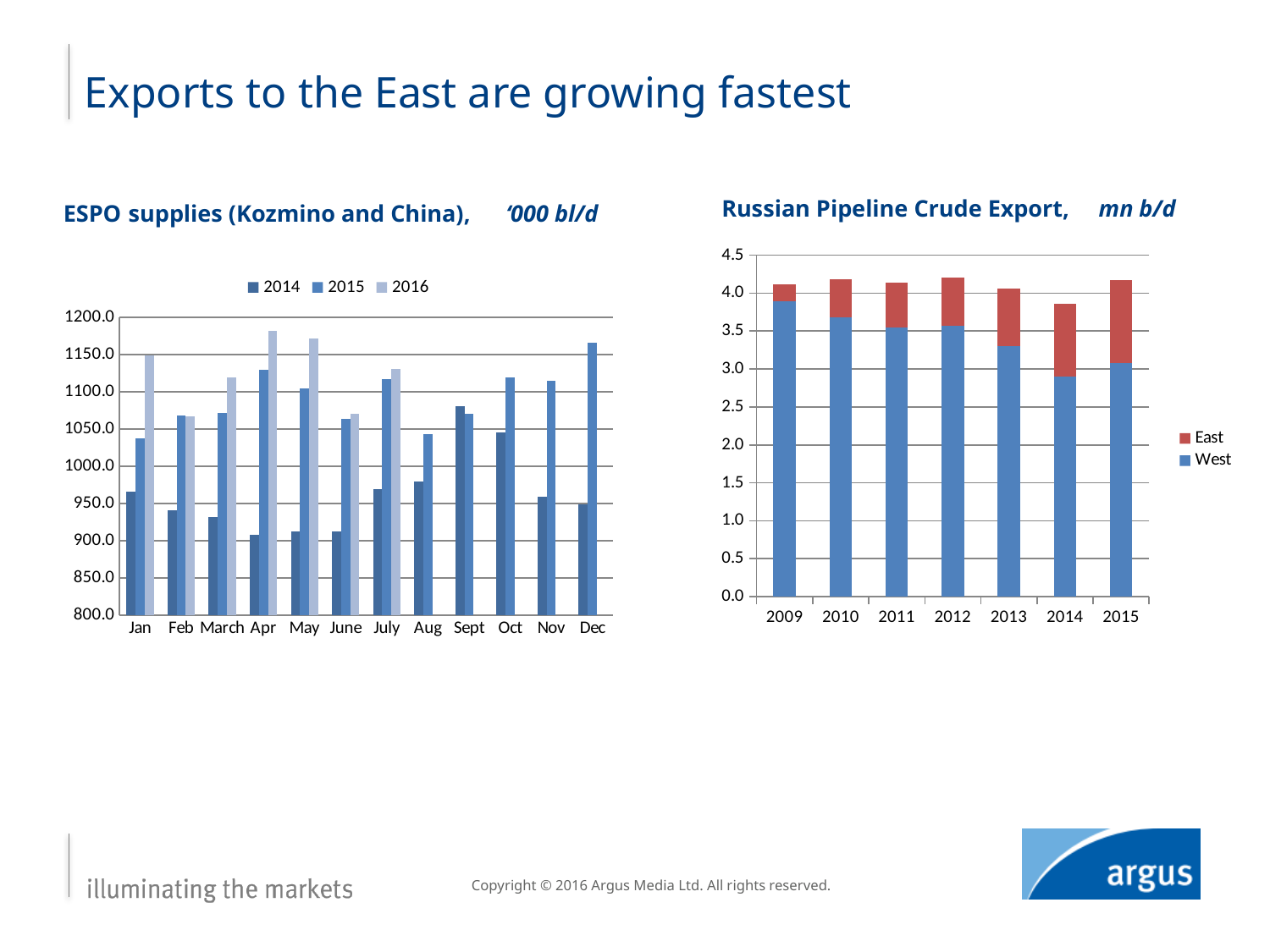
In the ESPO supplies (Kozmino and China) chart, which month has the highest 2014 value? Sept How many months are shown on the x axis of the ESPO supplies (Kozmino and China) chart? 12 In the ESPO supplies (Kozmino and China) chart, is the 2014 value for Apr greater or less than 950.0? less What kind of chart is the ESPO supplies (Kozmino and China) chart? bar chart In the Russian Pipeline Crude Export chart, which year has the lowest West value? 2014 In the ESPO supplies (Kozmino and China) chart, is the 2015 value for Dec greater or less than 1150.0? greater In the ESPO supplies (Kozmino and China) chart, which is larger for Jan: the 2015 value or the 2016 value? 2016 In the Russian Pipeline Crude Export chart, which colour represents East? red How many series does the legend of the ESPO supplies (Kozmino and China) chart list? 3 What kind of chart is the Russian Pipeline Crude Export chart? stacked bar chart In the Russian Pipeline Crude Export chart, is the West value for 2009 greater or less than 3.5? greater In the ESPO supplies (Kozmino and China) chart, which month has the highest 2015 value? Dec